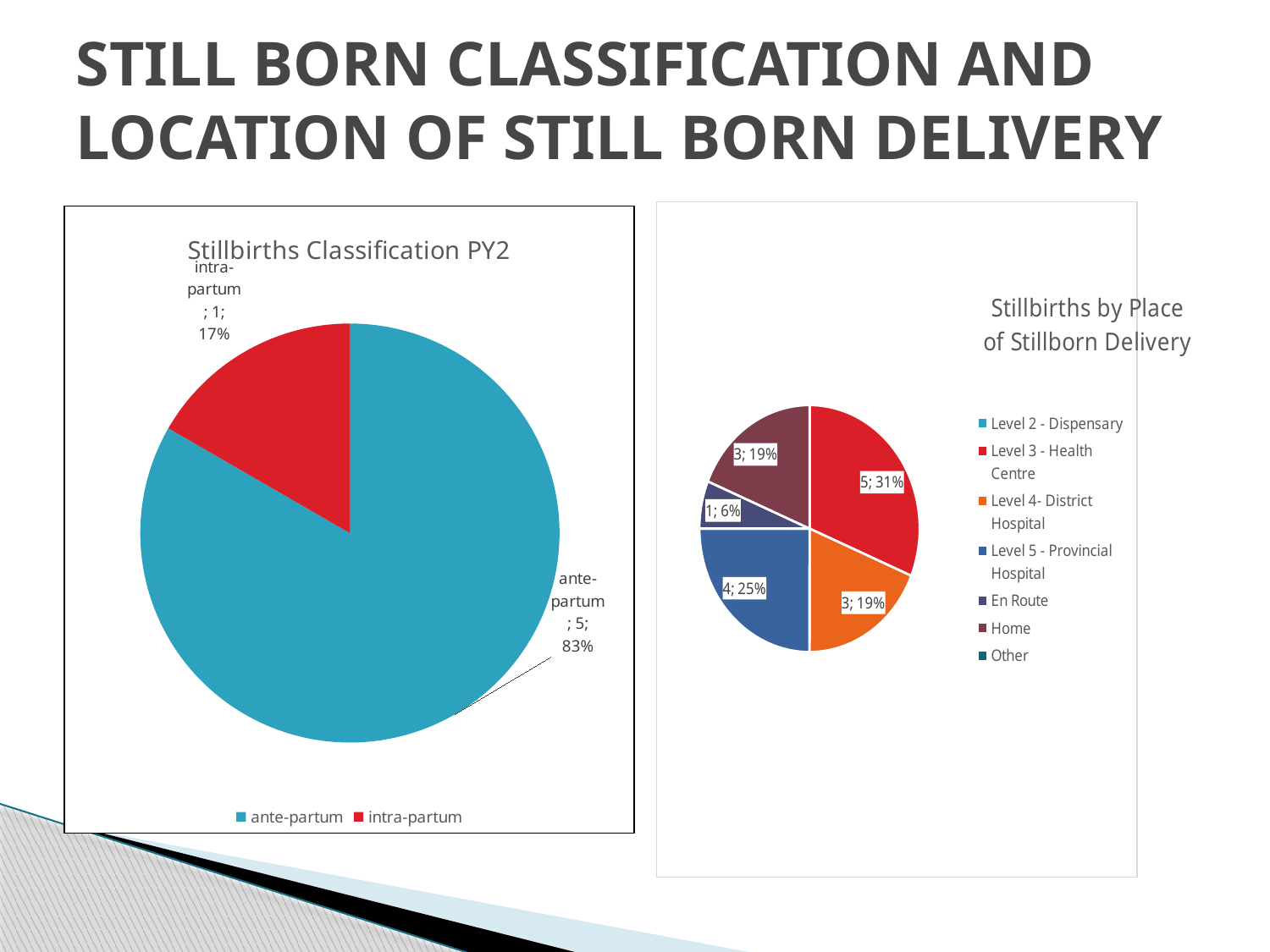
In the Stillbirths by Place of Stillborn Delivery chart, which is larger, Level 4- District Hospital or Level 5 - Provincial Hospital? Level 5 - Provincial Hospital In the Stillbirths by Place of Stillborn Delivery chart, what percentage share does Level 5 - Provincial Hospital have? 25% In the Stillbirths Classification PY2 chart, which category is the largest? ante-partum In the Stillbirths by Place of Stillborn Delivery chart, what is the difference between the Level 3 - Health Centre value and the Home value? 2 What kind of chart is the Stillbirths Classification PY2 chart? pie chart In the Stillbirths by Place of Stillborn Delivery chart, which category has the smallest slice? En Route In the Stillbirths Classification PY2 chart, what is the difference between the ante-partum and intra-partum values? 4 How many entries does the legend of the Stillbirths by Place of Stillborn Delivery chart list? 7 In the Stillbirths by Place of Stillborn Delivery chart, what is the value for Level 3 - Health Centre? 5 In the Stillbirths Classification PY2 chart, what percentage share does intra-partum have? 17% In the Stillbirths Classification PY2 chart, what is the value for ante-partum? 5 How many entries does the legend of the Stillbirths Classification PY2 chart list? 2